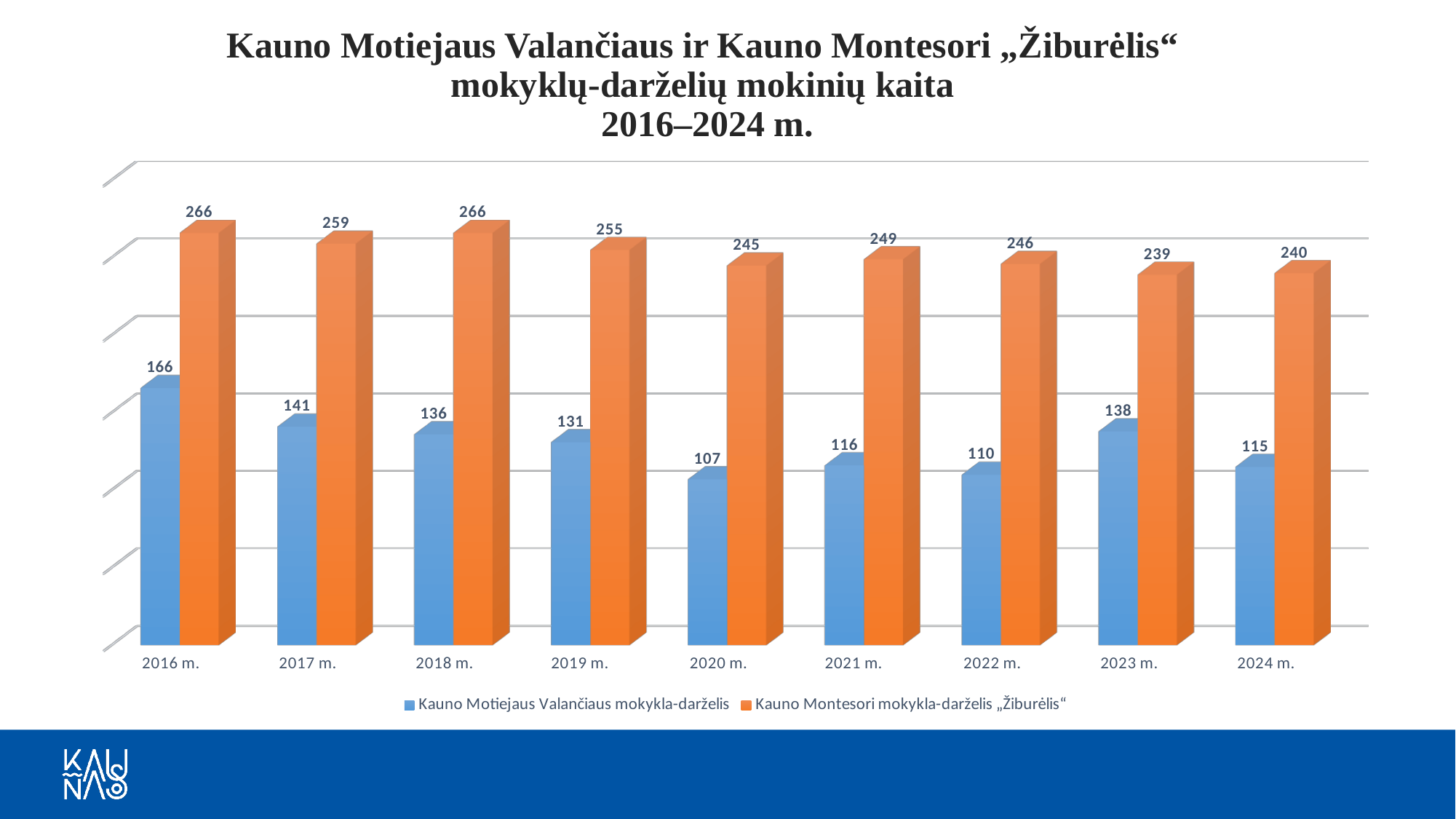
What kind of chart is shown on the slide? Bar chart How many years are shown on the x axis? 9 Which colour represents Kauno Montesori mokykla-darželis „Žiburėlis“ in the chart? Orange What is the value for Kauno Montesori mokykla-darželis „Žiburėlis“ in 2020 m.? 245 What is the value for Kauno Motiejaus Valančiaus mokykla-darželis in 2024 m.? 115 How many series does the legend list? 2 In which year is the value for Kauno Montesori mokykla-darželis „Žiburėlis“ lowest? 2023 m. Which is larger for Kauno Motiejaus Valančiaus mokykla-darželis: the value in 2021 m. or in 2023 m.? 2023 m. In which year is the value for Kauno Motiejaus Valančiaus mokykla-darželis lowest? 2020 m. What is the difference between the two series' values in 2016 m.? 100 What is the difference between the Kauno Motiejaus Valančiaus mokykla-darželis values in 2016 m. and 2017 m.? 25 What is the value for Kauno Motiejaus Valančiaus mokykla-darželis in 2016 m.? 166